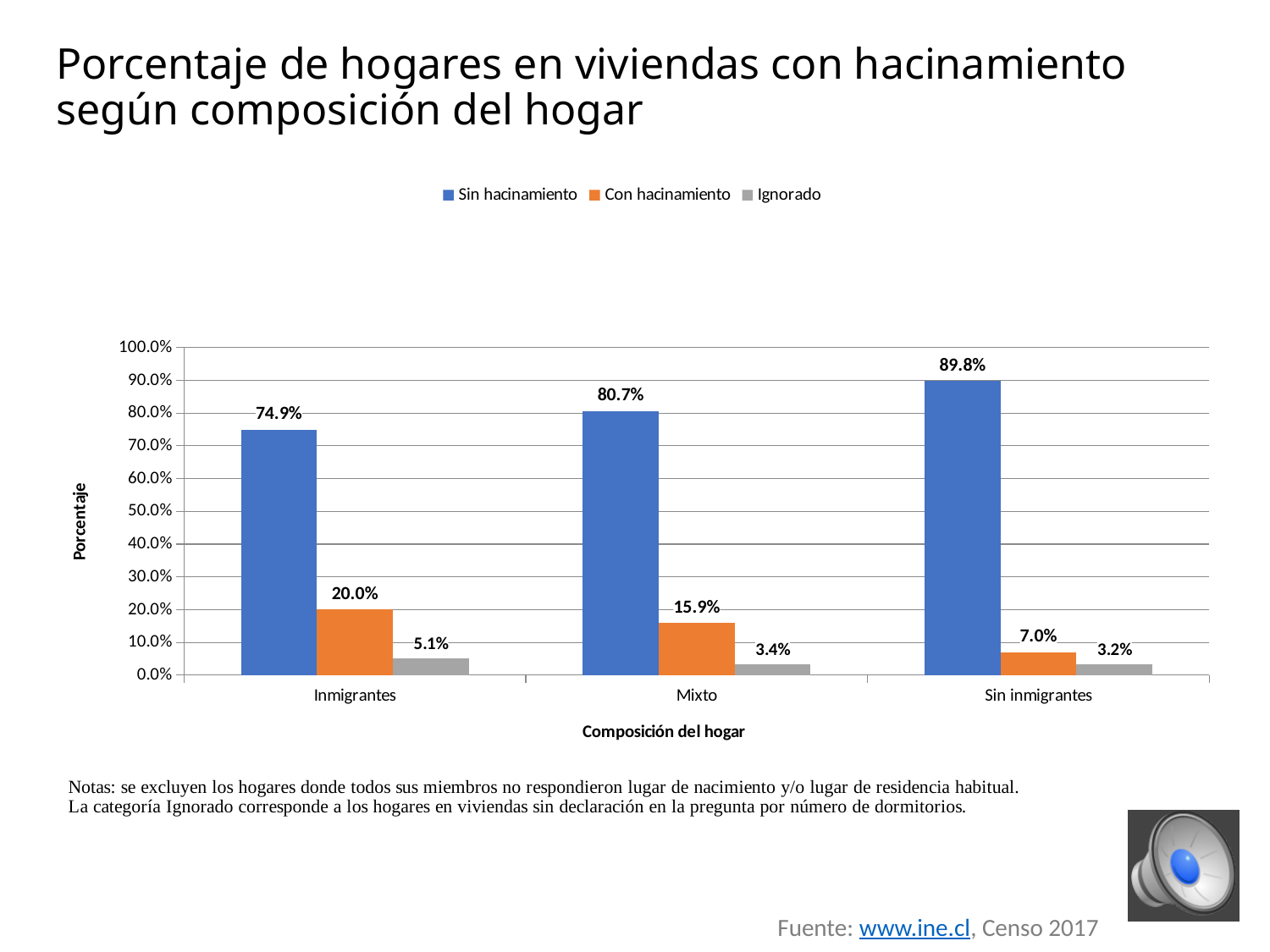
What is the value of Sin hacinamiento for Inmigrantes? 74.9% What kind of chart is shown on the slide? Bar chart Is the Sin hacinamiento value for Mixto greater or less than 70.0%? greater How many series does the legend list? 3 Which household composition has the highest Sin hacinamiento value? Sin inmigrantes What is the value of Ignorado for Sin inmigrantes? 3.2% What is the value of Con hacinamiento for Mixto? 15.9% Which household composition has the lowest Con hacinamiento value? Sin inmigrantes Which is larger: the Ignorado value for Inmigrantes or for Mixto? Inmigrantes How many household composition categories are shown on the x axis? 3 What is the label of the y axis? Porcentaje What is the difference between the Con hacinamiento values for Inmigrantes and Sin inmigrantes? 13.0%